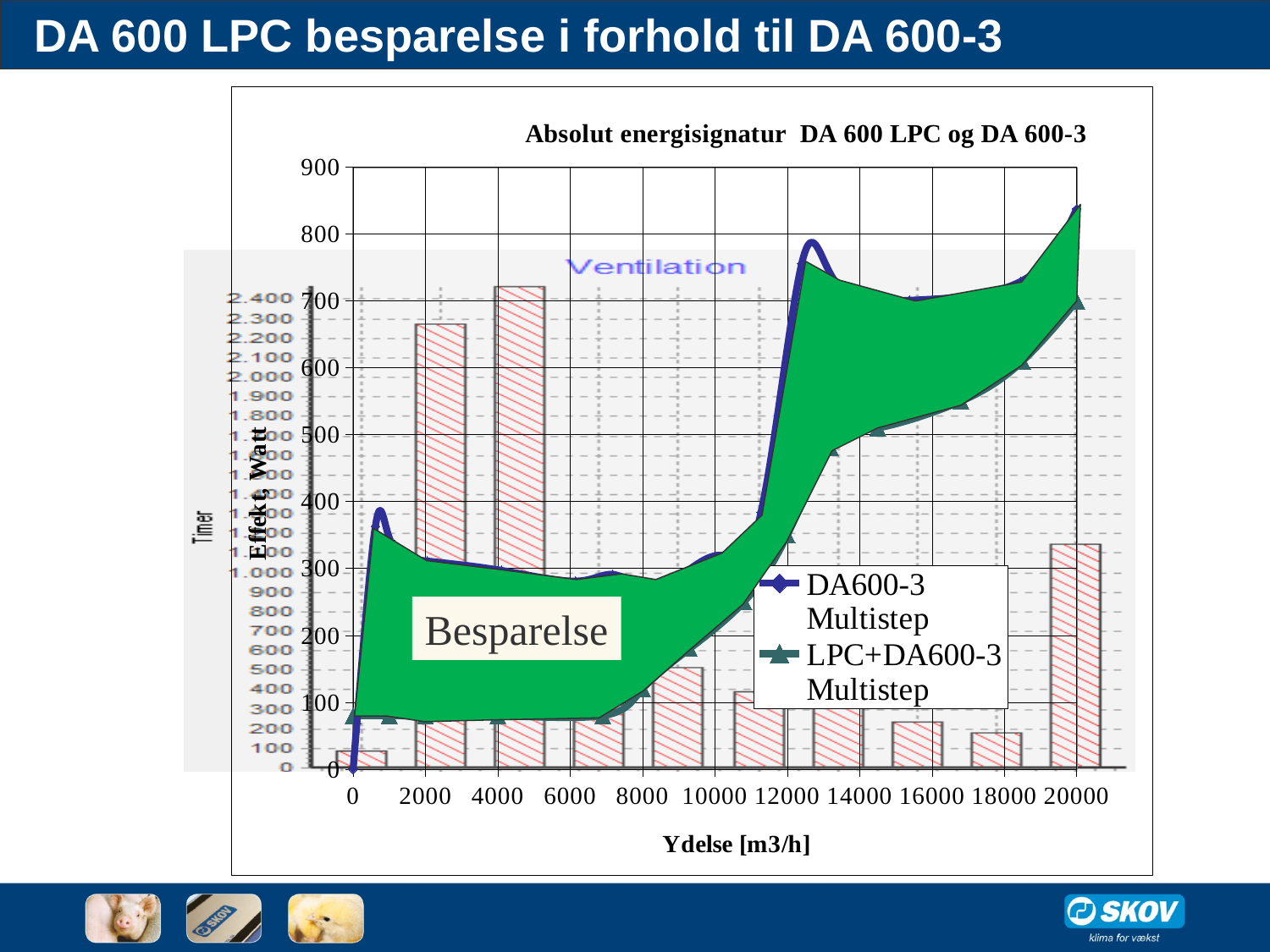
What kind of chart is shown on the slide? line chart What is the title of the chart? Absolut energisignatur DA 600 LPC og DA 600-3 Is the value of DA600-3 Multistep at 20000 m3/h greater or less than 800? greater Is the value of LPC+DA600-3 Multistep at 2000 m3/h greater or less than 100? less At 12000 m3/h, which series has the higher value, DA600-3 Multistep or LPC+DA600-3 Multistep? DA600-3 Multistep At which x-axis value does the DA600-3 Multistep series reach its highest value? 20000 How many series does the legend of the chart list? 2 Does the LPC+DA600-3 Multistep series generally rise or fall from 2000 to 20000 m3/h? rise What is the label of the x axis of the chart? Ydelse [m3/h] Is the value of LPC+DA600-3 Multistep at 8000 m3/h greater or less than 200? less